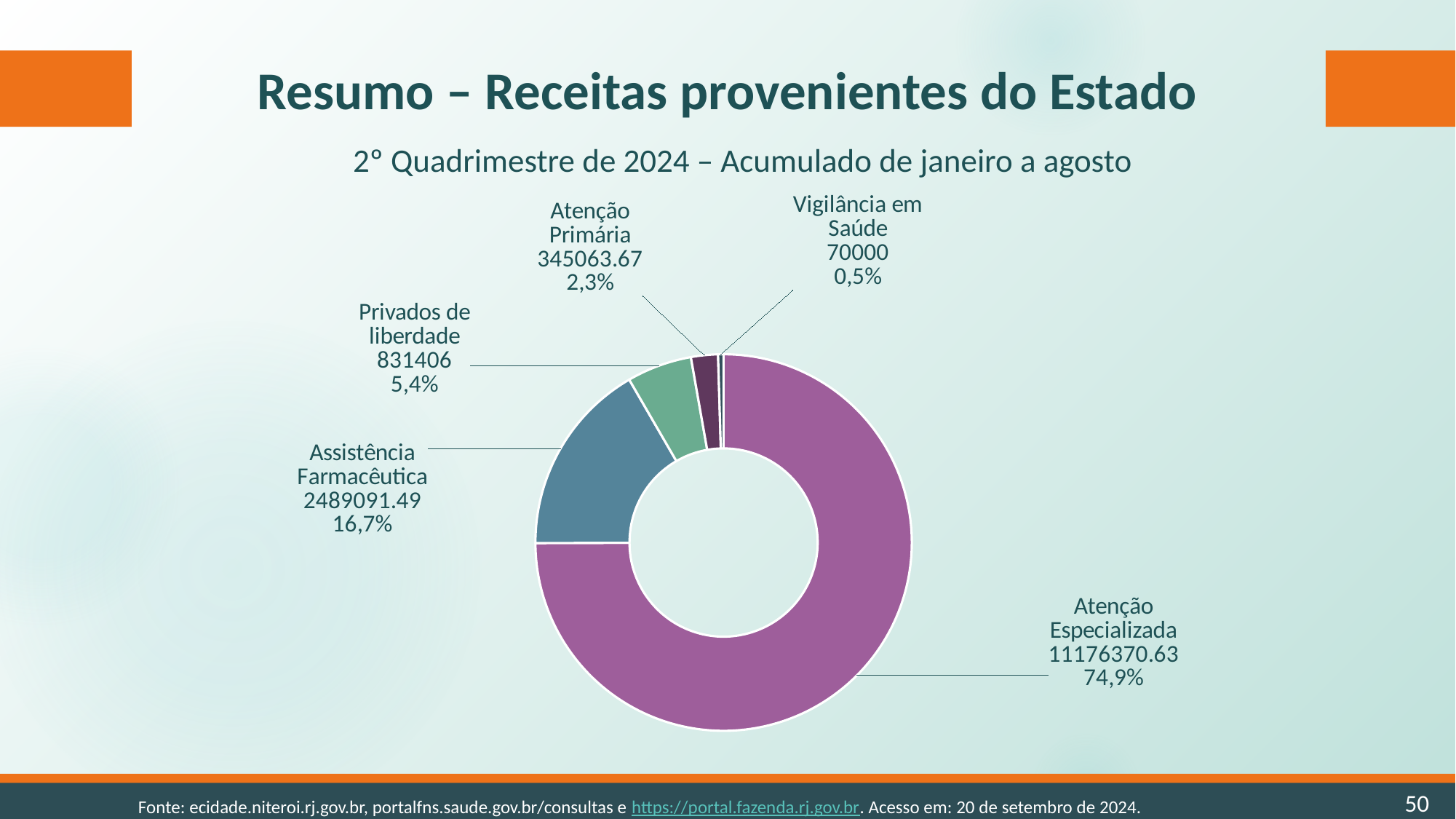
What is the difference between the values for Privados de liberdade and Vigilância em Saúde? 761406 Which category has the lowest value? Vigilância em Saúde Which is larger, the value for Privados de liberdade or the value for Atenção Primária? Privados de liberdade What is the value for Atenção Especializada? 11176370.63 What is the value for Privados de liberdade? 831406 What share of the chart does Atenção Primária represent? 2,3% What is the value for Vigilância em Saúde? 70000 What kind of chart is shown on the slide? doughnut chart Which category has the highest value? Atenção Especializada What is the value for Assistência Farmacêutica? 2489091.49 What share of the chart does Assistência Farmacêutica represent? 16,7% How many categories are shown in the chart? 5